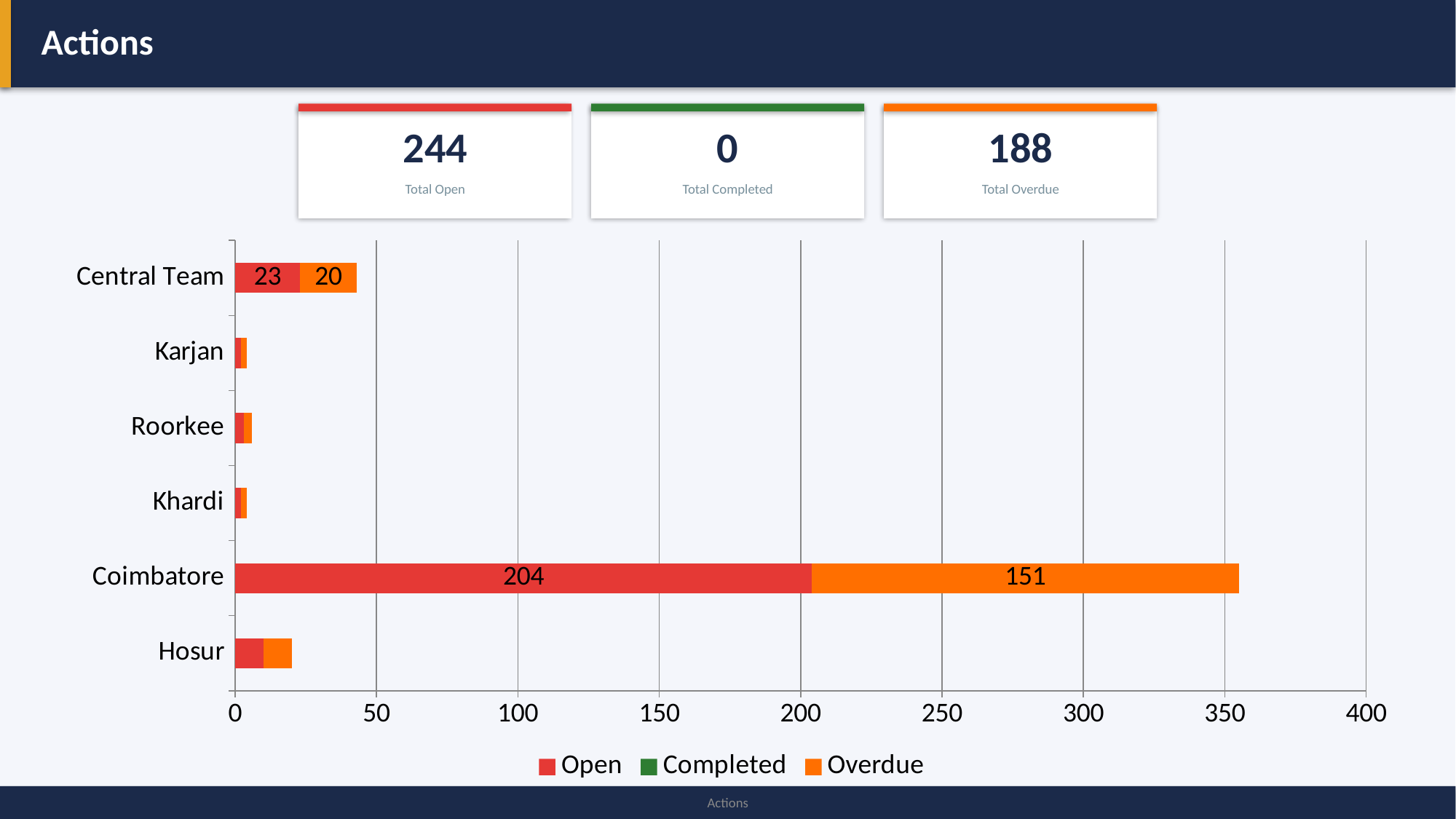
Is the total stacked bar for Hosur greater or less than 50? less How many series does the legend list? 3 How many categories are shown on the chart? 6 Which category has the longest stacked bar? Coimbatore What is the Overdue value for Coimbatore? 151 What is the Open value for Coimbatore? 204 What is the total of the stacked bar for Central Team? 43 What is the difference between the Open and Overdue values for Coimbatore? 53 What is the total of the stacked bar for Coimbatore? 355 What is the Overdue value for Central Team? 20 What is the Open value for Central Team? 23 Which has a longer stacked bar, Central Team or Hosur? Central Team